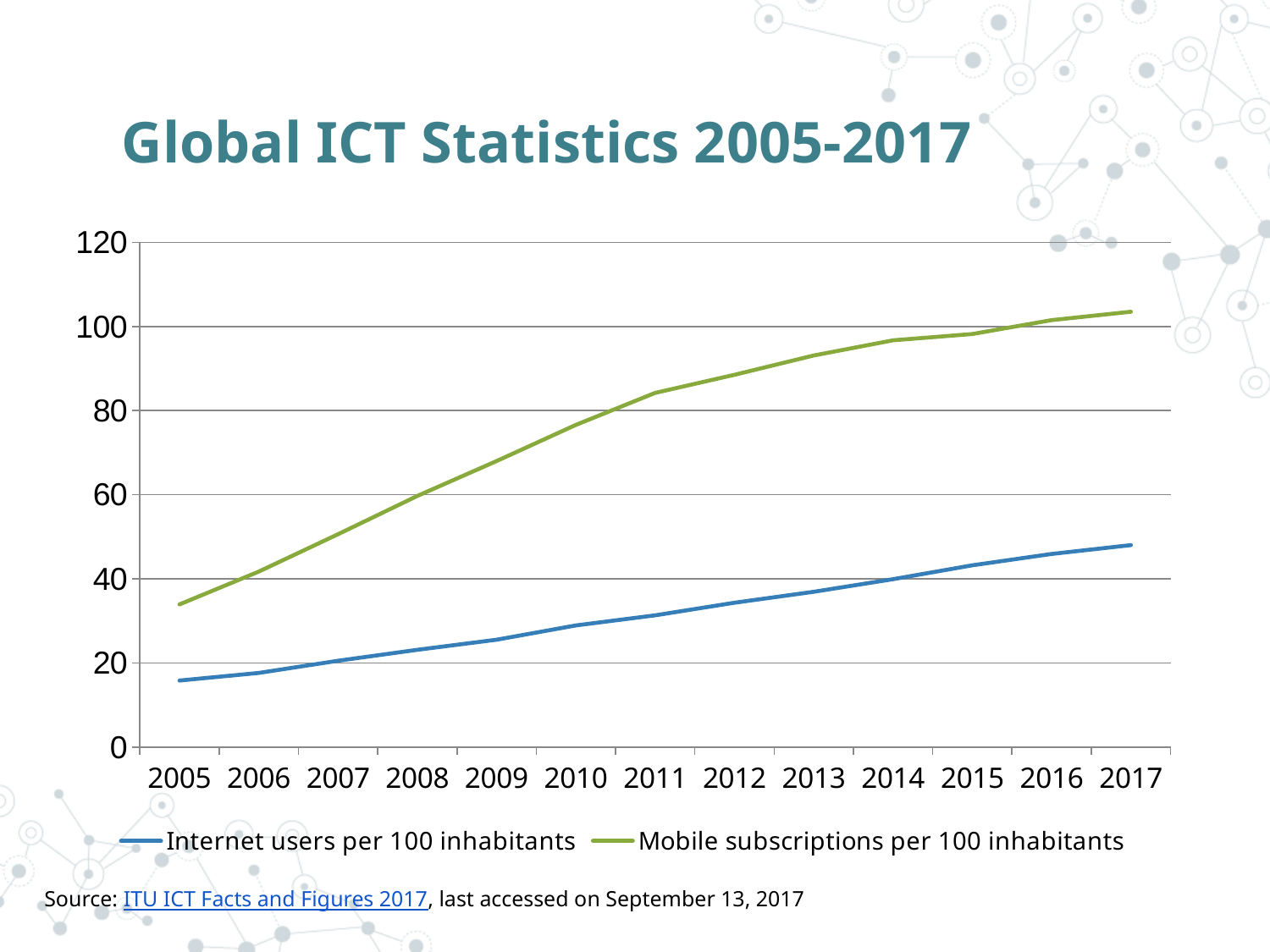
Is the value for Mobile subscriptions per 100 inhabitants in 2005 greater or less than 40? less Is the value for Internet users per 100 inhabitants in 2005 greater or less than 20? less Do the values for Mobile subscriptions per 100 inhabitants rise or fall from 2005 to 2017? rise Is the value for Mobile subscriptions per 100 inhabitants in 2017 greater or less than 100? greater How many series does the legend list? 2 What is the title of the chart on the slide? Global ICT Statistics 2005-2017 In which year is Internet users per 100 inhabitants lowest? 2005 Do the values for Internet users per 100 inhabitants rise or fall from 2005 to 2017? rise In 2017, which series has the larger value: Internet users per 100 inhabitants or Mobile subscriptions per 100 inhabitants? Mobile subscriptions per 100 inhabitants How many years are plotted along the x axis? 13 In which year is Mobile subscriptions per 100 inhabitants highest? 2017 What kind of chart is shown on the slide? line chart